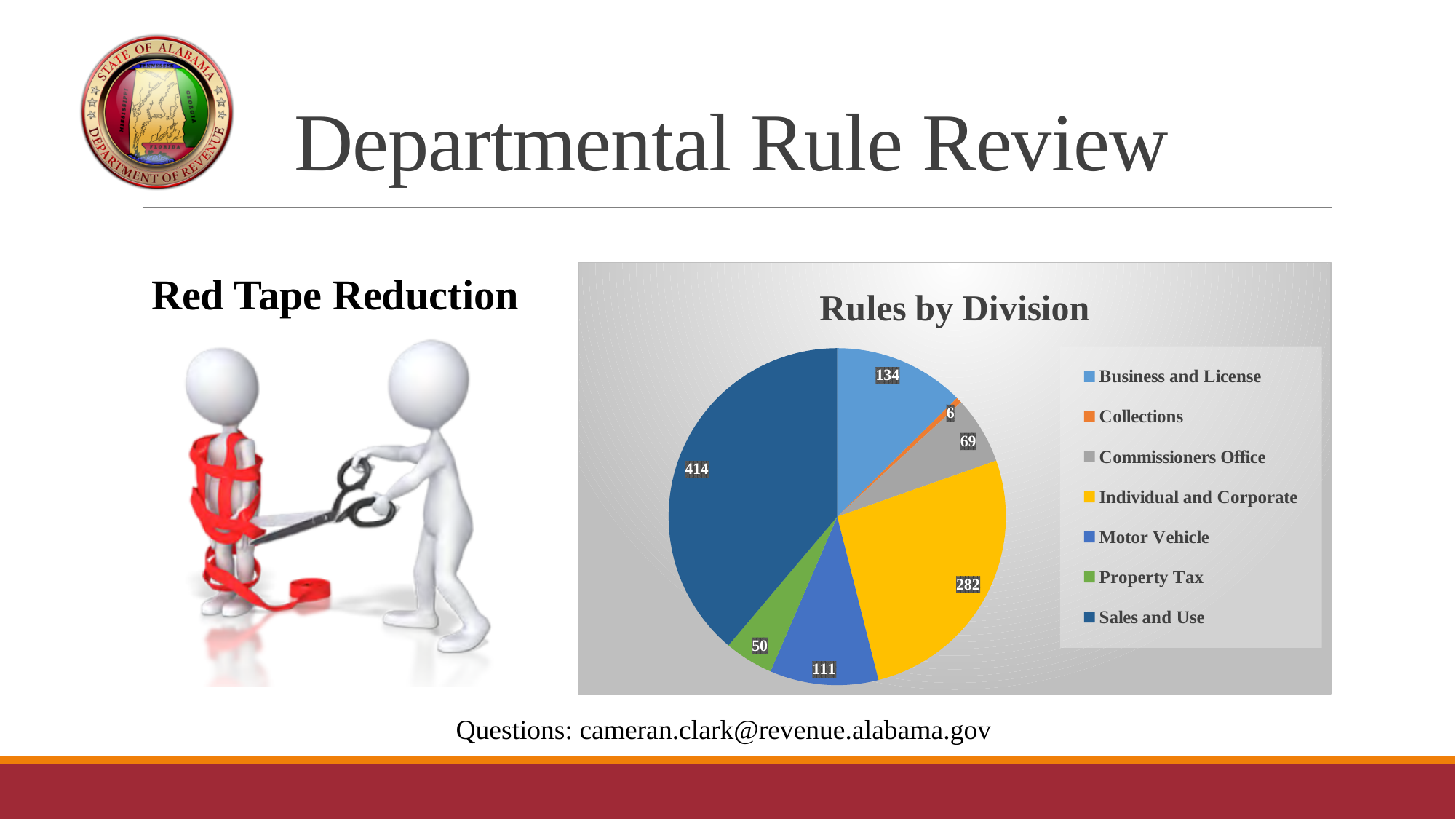
Which has more rules, Business and License or Commissioners Office? Business and License How many rules does the Individual and Corporate division have? 282 What is the difference between the number of rules for Sales and Use and Individual and Corporate? 132 How many rules does the Motor Vehicle division have? 111 What is the total number of rules across all divisions in the chart? 1066 What is the title of the chart? Rules by Division How many rules does the Collections division have? 6 What type of chart is shown on the slide? Pie chart Which division has the most rules? Sales and Use How many rules does the Sales and Use division have? 414 Which division has the fewest rules? Collections How many divisions are listed in the chart legend? 7